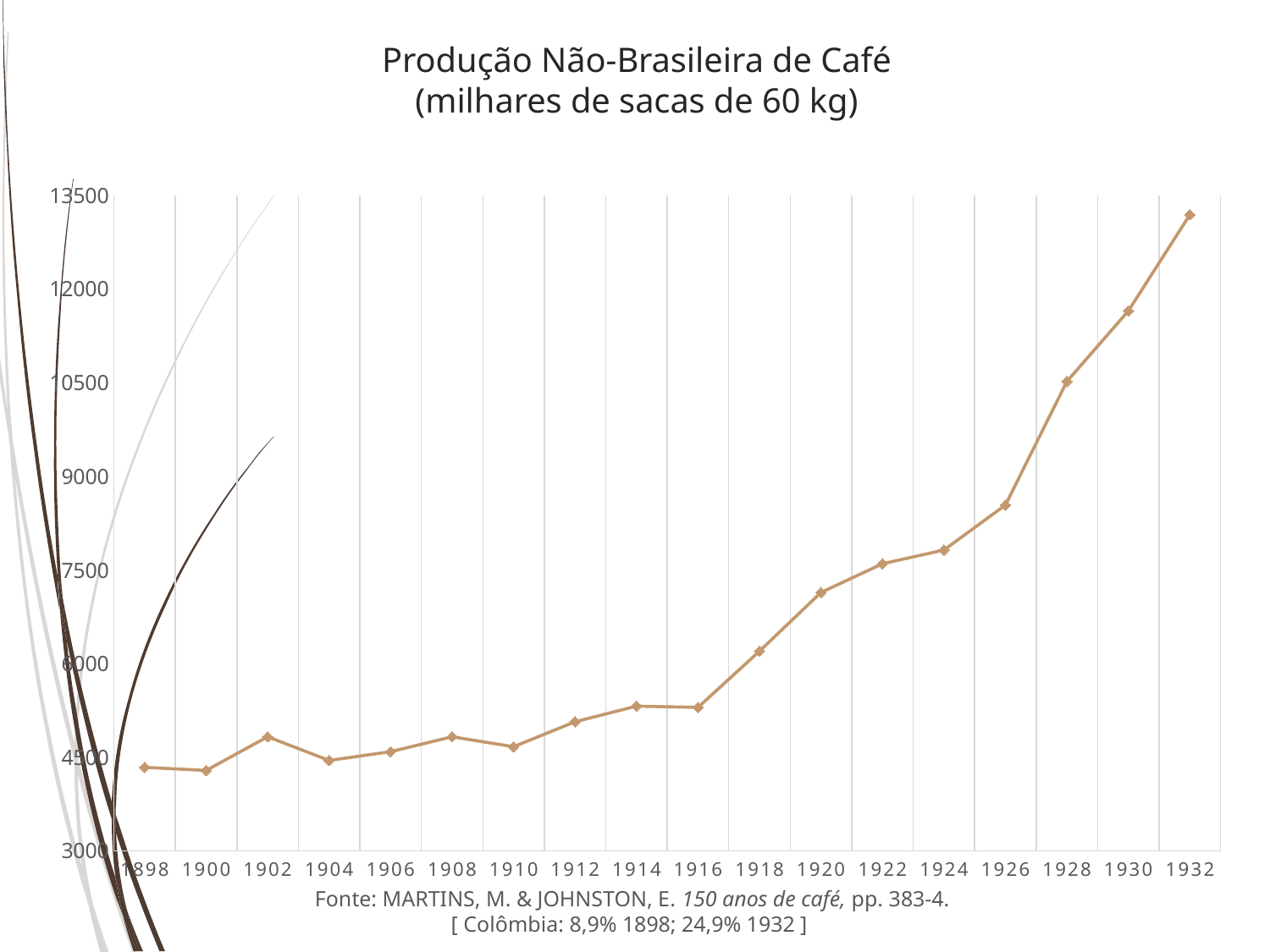
What is the title of the chart? Produção Não-Brasileira de Café (milhares de sacas de 60 kg) Is the value for 1932 greater or less than 12000? greater Do the values generally rise or fall from 1898 to 1932? rise Which year has the highest value? 1932 What kind of chart is shown on the slide? line chart Which year has the larger value, 1910 or 1920? 1920 Is the value for 1916 greater or less than 6000? less Is the value for 1926 greater or less than 9000? less Which year has the larger value, 1898 or 1932? 1932 How many data points are plotted on the line? 18